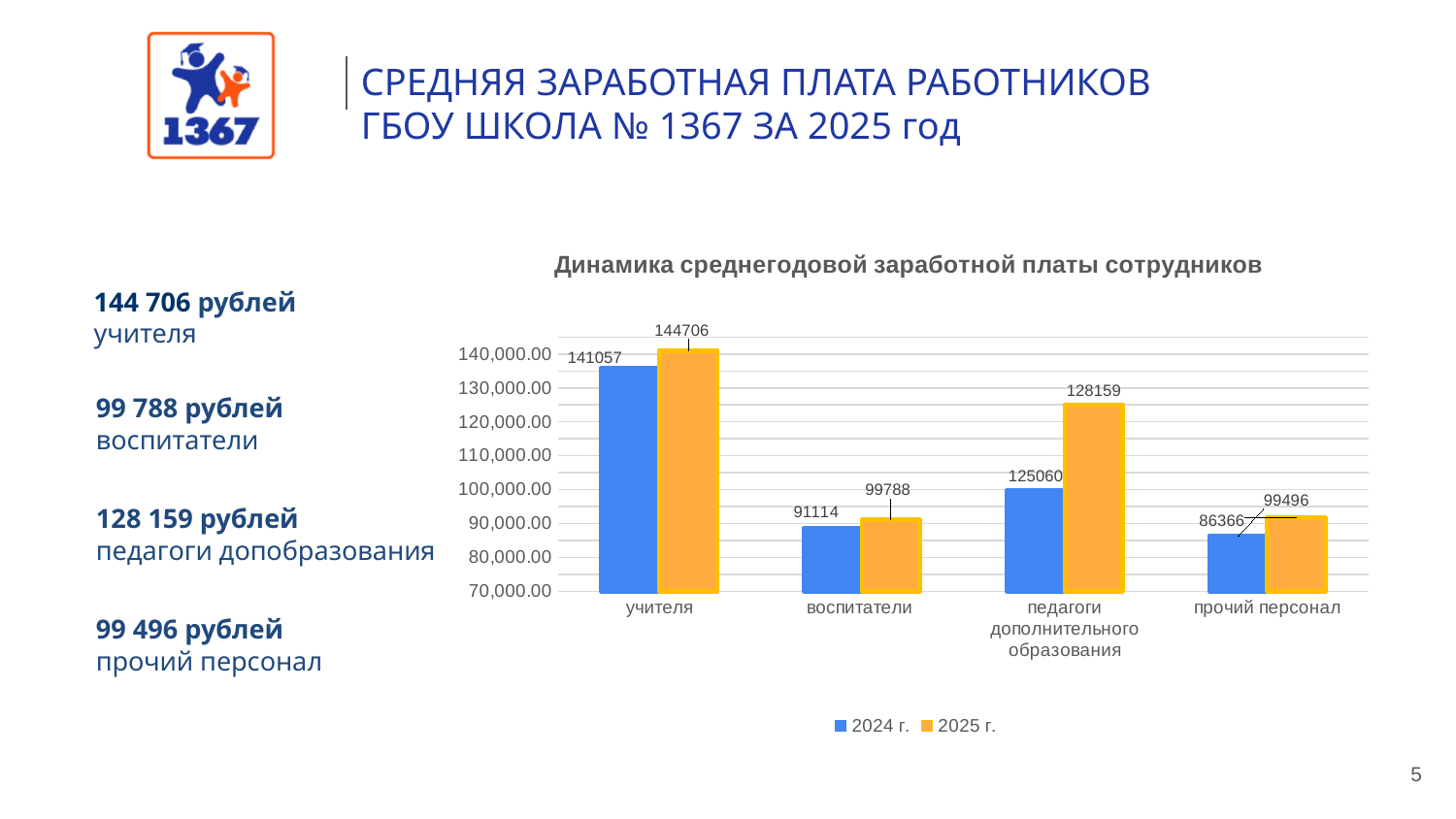
How many series does the chart legend list? 2 What is the value for учителя in 2025 г.? 144706 What is the difference between the 2025 г. and 2024 г. values for учителя? 3649 Which category has the lowest value in 2024 г.? прочий персонал What is the difference between the 2025 г. and 2024 г. values for прочий персонал? 13130 What is the title of the chart? Динамика среднегодовой заработной платы сотрудников Which category has the highest value in 2025 г.? учителя What is the value for воспитатели in 2024 г.? 91114 What type of chart is shown on the slide? bar chart What is the value for прочий персонал in 2025 г.? 99496 How many categories are shown on the x axis of the chart? 4 Which is larger: the 2025 г. value for воспитатели or the 2025 г. value for прочий персонал? воспитатели